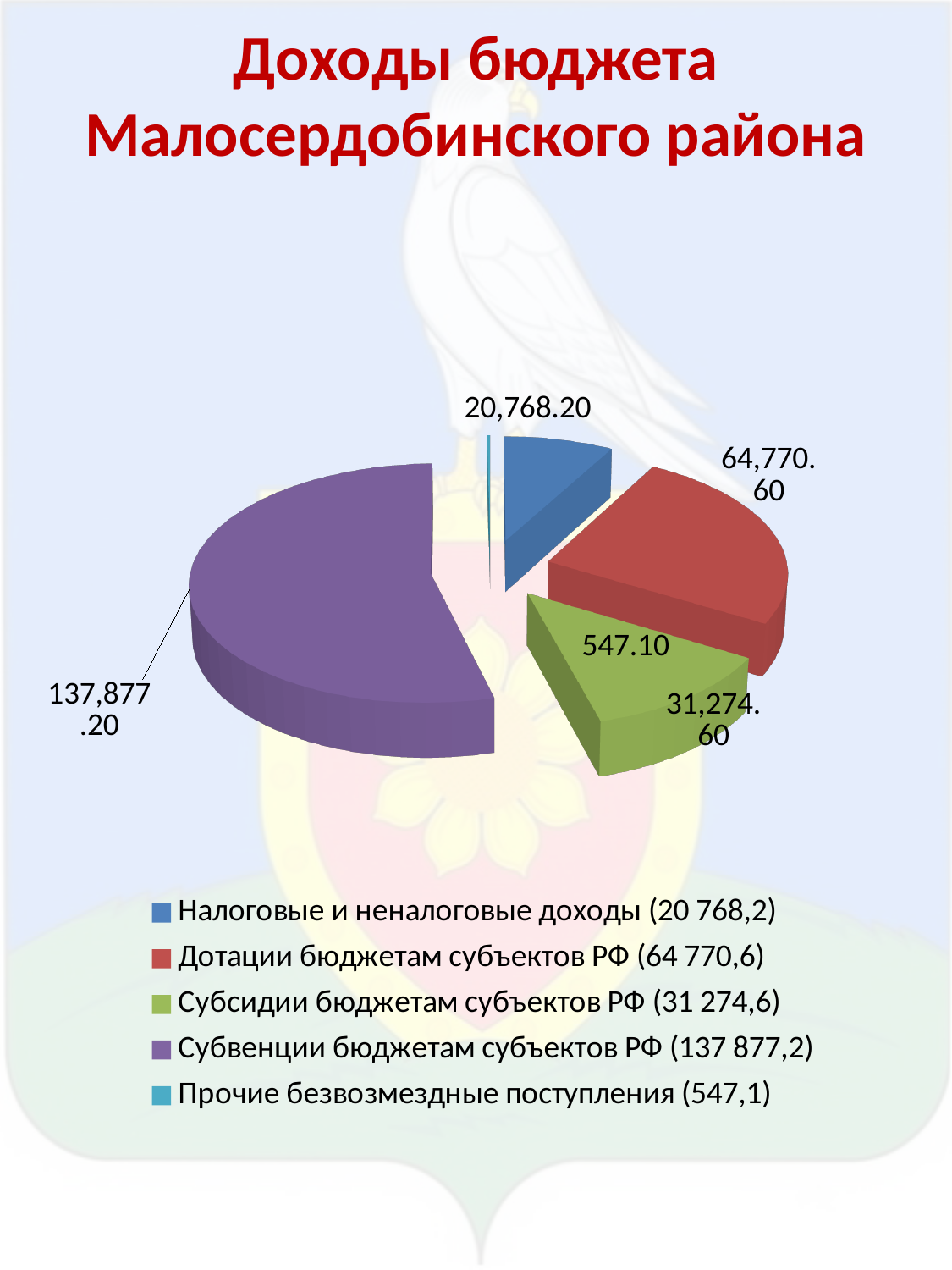
What is the value shown for Субсидии бюджетам субъектов РФ? 31,274.60 What kind of chart is shown on the slide? pie chart What is the difference between the values for Субвенции бюджетам субъектов РФ and Дотации бюджетам субъектов РФ? 73,106.60 Which is larger, Дотации бюджетам субъектов РФ or Субсидии бюджетам субъектов РФ? Дотации бюджетам субъектов РФ Which category has the largest slice of the pie? Субвенции бюджетам субъектов РФ What is the value shown for Прочие безвозмездные поступления? 547.10 Which category has the smallest slice of the pie? Прочие безвозмездные поступления What is the title of the slide containing the chart? Доходы бюджета Малосердобинского района How many slices does the pie chart have? 5 How many entries does the legend list? 5 What is the value shown for Налоговые и неналоговые доходы? 20,768.20 What is the value shown for Субвенции бюджетам субъектов РФ? 137,877.20